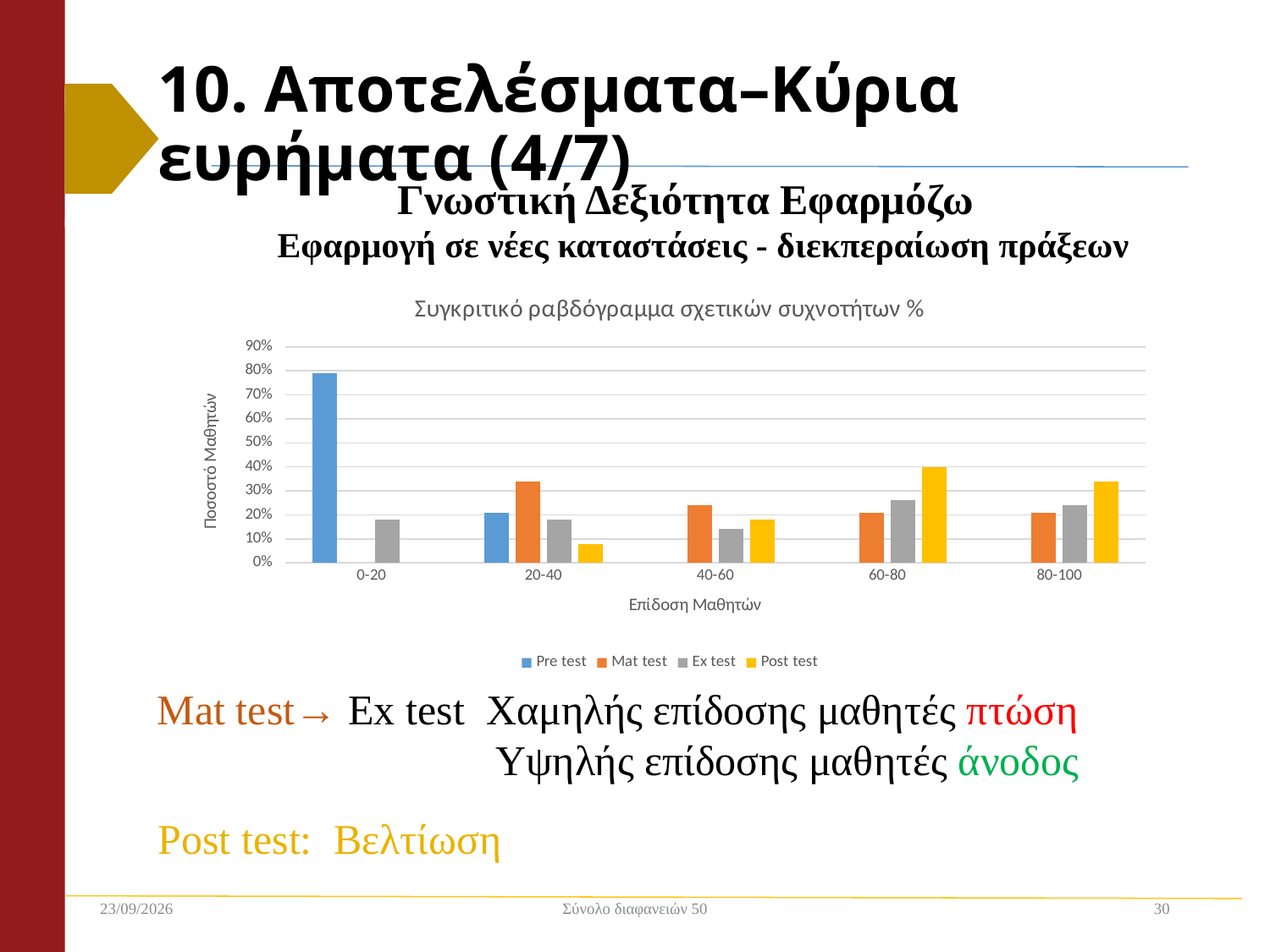
How many categories are shown on the x axis? 5 What is the title of the chart? Συγκριτικό ραβδόγραμμα σχετικών συχνοτήτων % Is the Post test value for 20-40 greater or less than 10%? less Which category has the lowest Post test bar? 20-40 Is the Pre test value for 0-20 greater or less than 70%? greater Is the Mat test value for 20-40 greater or less than 30%? greater How many series does the legend list? 4 Which is larger for the 60-80 category, the Mat test value or the Post test value? Post test What is the label of the x axis? Επίδοση Μαθητών Which category has the highest Pre test bar? 0-20 What kind of chart is shown on the slide? bar chart